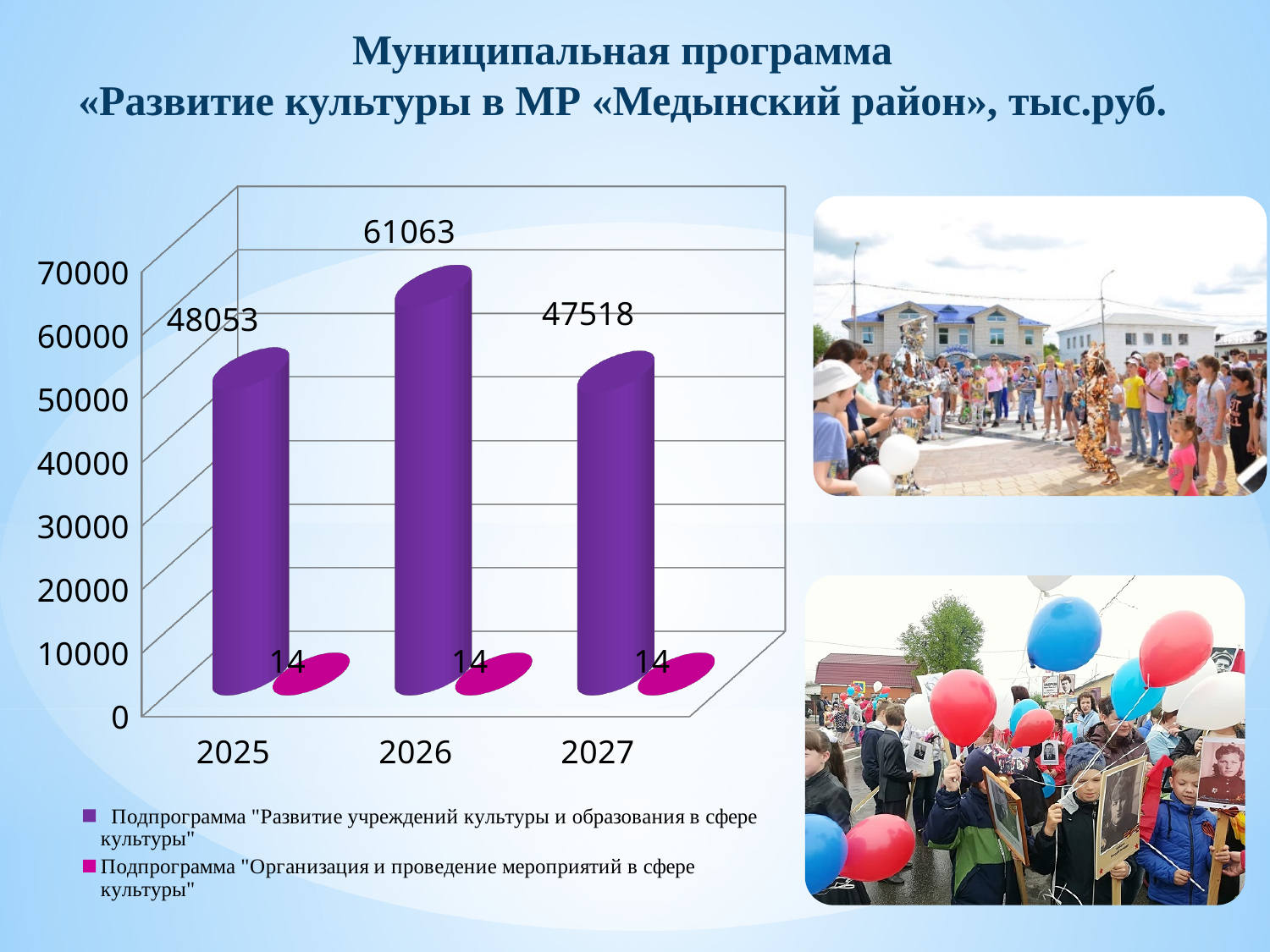
Which is larger for the series "Подпрограмма "Развитие учреждений культуры и образования в сфере культуры"": the value for 2025 or the value for 2027? 2025 How many series does the chart legend list? 2 What kind of chart is shown on the slide? bar chart What colour are the bars for the series "Подпрограмма "Организация и проведение мероприятий в сфере культуры""? magenta How many years are shown on the x axis of the chart? 3 What is the difference between the 2026 and 2025 values for the series "Подпрограмма "Развитие учреждений культуры и образования в сфере культуры""? 13010 Which year has the lowest value for the series "Подпрограмма "Развитие учреждений культуры и образования в сфере культуры""? 2027 Is the 2026 value for the series "Подпрограмма "Развитие учреждений культуры и образования в сфере культуры"" greater or less than 50000? greater What is the value for 2027 for the series "Подпрограмма "Организация и проведение мероприятий в сфере культуры""? 14 What is the value for 2025 for the series "Подпрограмма "Развитие учреждений культуры и образования в сфере культуры""? 48053 What is the value for 2026 for the series "Подпрограмма "Развитие учреждений культуры и образования в сфере культуры""? 61063 Which year has the highest value for the series "Подпрограмма "Развитие учреждений культуры и образования в сфере культуры""? 2026